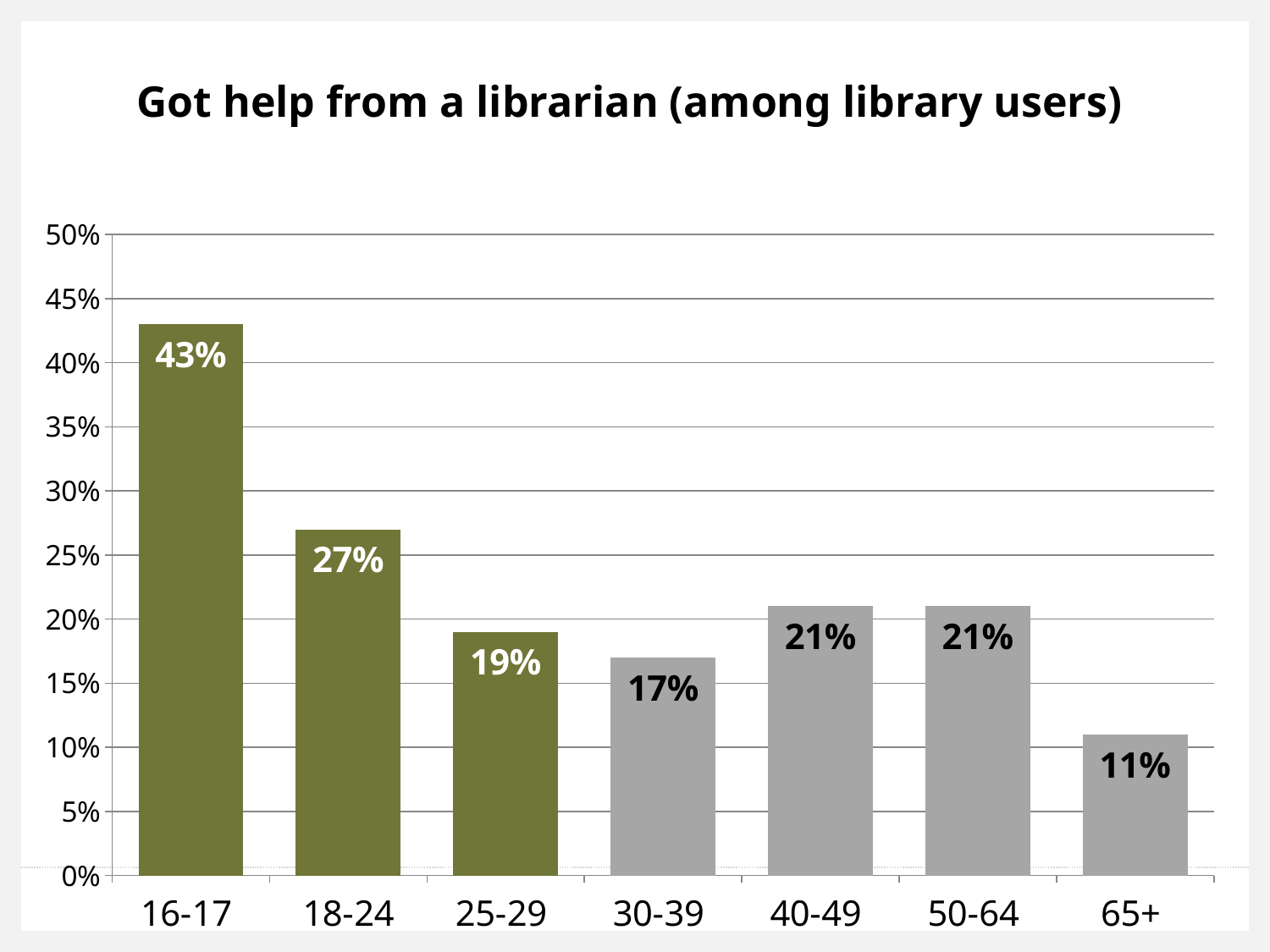
How many age groups are shown in the chart? 7 What percentage of library users aged 16-17 got help from a librarian? 43% What is the difference between the values for 25-29 and 65+? 8% What is the value for the 65+ age group? 11% Which is larger, the value for 18-24 or the value for 40-49? 18-24 Which age group has the lowest value? 65+ What is the title of the chart? Got help from a librarian (among library users) Which age group has the highest percentage of library users who got help from a librarian? 16-17 Is the value for 16-17 greater or less than 40%? greater What is the value for the 30-39 age group? 17% What is the difference between the values for 16-17 and 18-24? 16% What kind of chart is shown on the slide? Bar chart